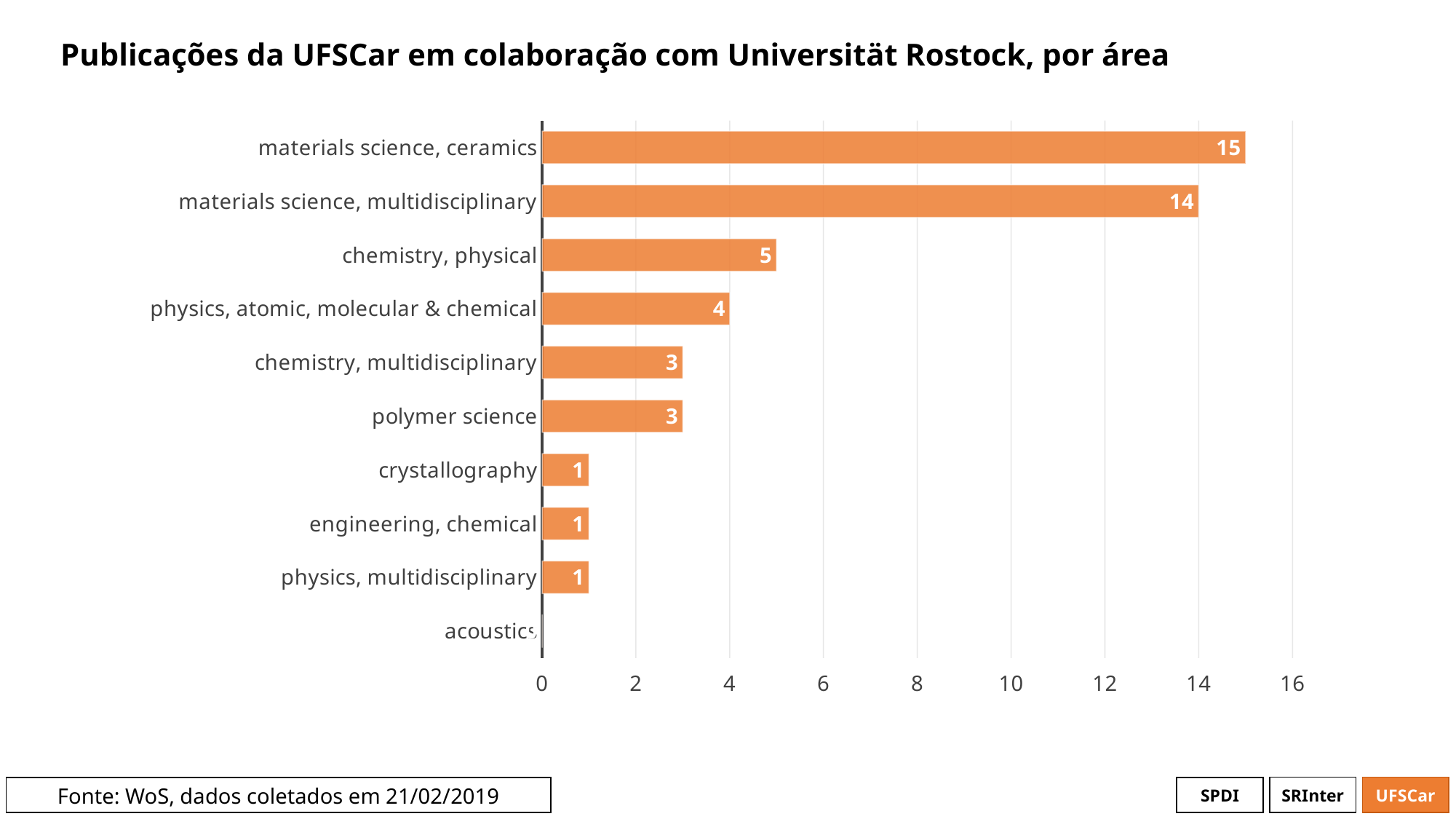
What kind of chart is shown on the slide? bar chart What is the title of the chart? Publicações da UFSCar em colaboração com Universität Rostock, por área Which area has the highest number of publications? materials science, ceramics What is the difference between materials science, ceramics and chemistry, physical? 10 What is the value for physics, atomic, molecular & chemical? 4 What is the value for materials science, multidisciplinary? 14 Which is larger, the value for chemistry, physical or the value for chemistry, multidisciplinary? chemistry, physical How many areas (categories) are listed on the chart? 10 How many publications are shown for materials science, ceramics? 15 Is the value for materials science, multidisciplinary greater or less than 10? greater What is the value for polymer science? 3 What is the value for chemistry, physical? 5